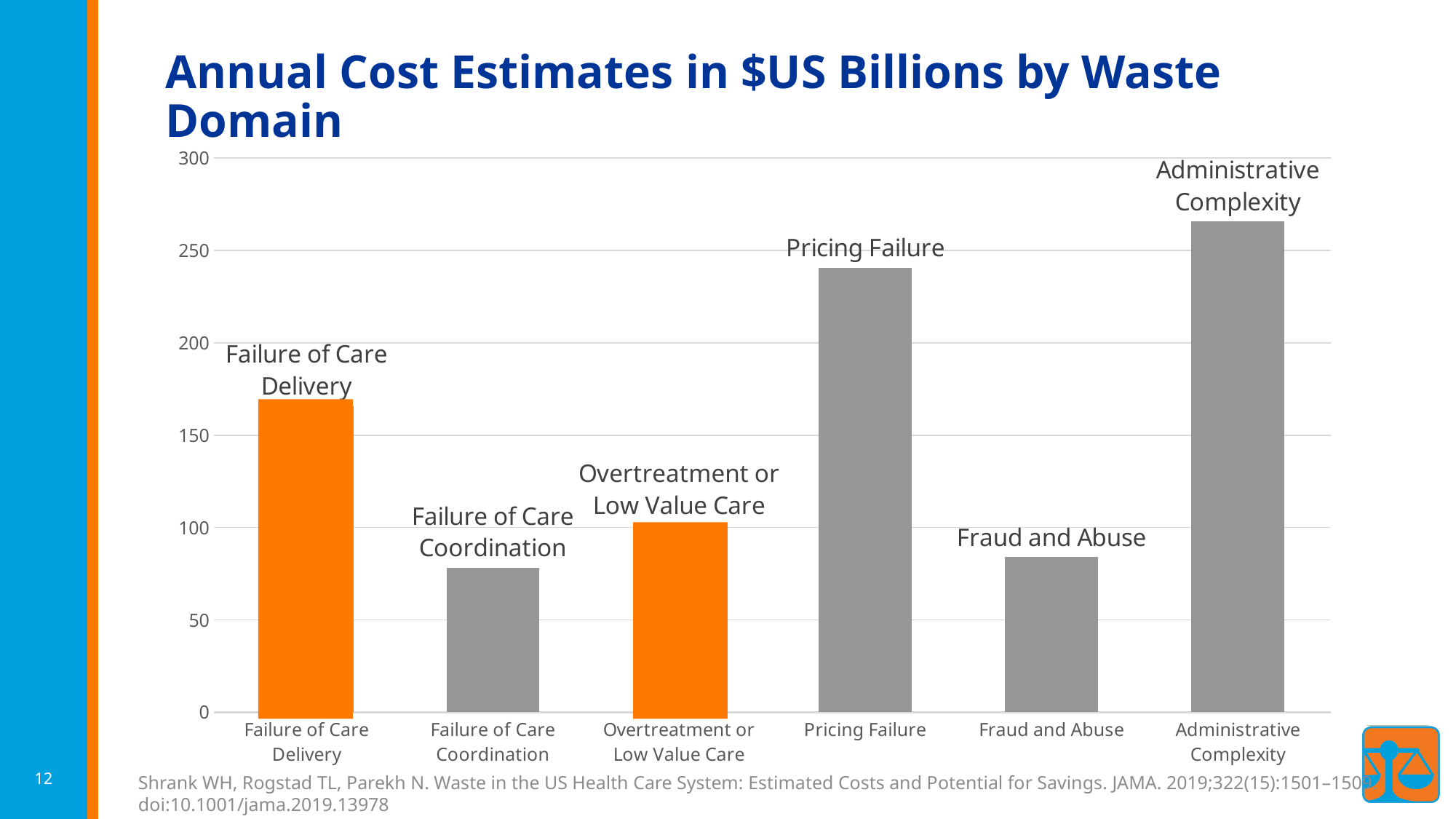
Which two bars in the chart are coloured orange? Failure of Care Delivery and Overtreatment or Low Value Care Is the value for Pricing Failure greater or less than 200? greater Is the value for Failure of Care Delivery greater or less than 150? greater How many waste domains (categories) are plotted in the chart? 6 Is the value for Failure of Care Coordination greater or less than 100? less What kind of chart is shown on the slide? bar chart Which is larger, the value for Failure of Care Delivery or the value for Overtreatment or Low Value Care? Failure of Care Delivery Which waste domain has the highest annual cost estimate? Administrative Complexity Which is larger, the value for Pricing Failure or the value for Administrative Complexity? Administrative Complexity